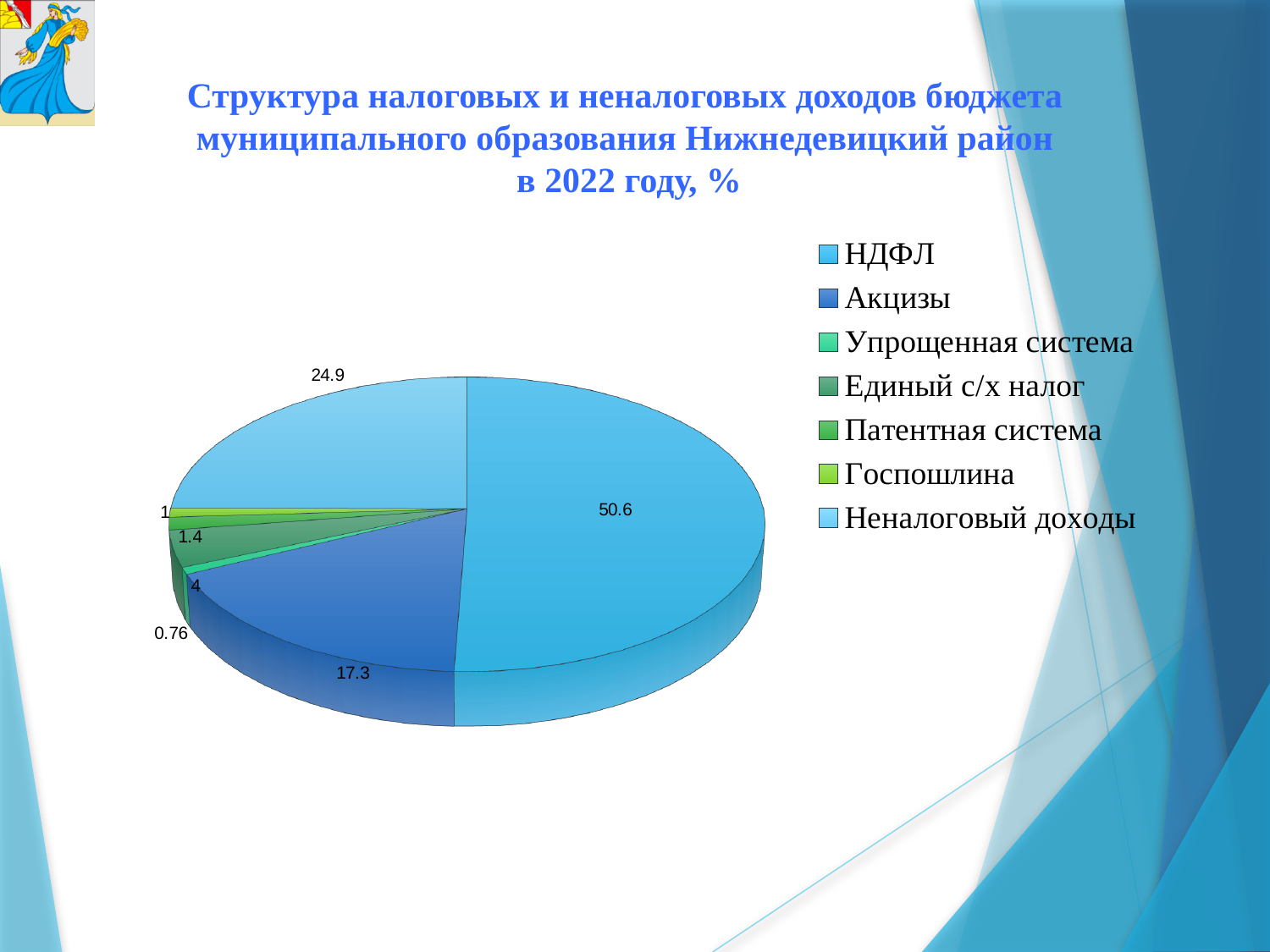
Which is larger, the value for Акцизы or the value for Неналоговый доходы? Неналоговый доходы Which category has the largest share of the pie? НДФЛ Which year does the chart title refer to? 2022 What is the difference between the values for НДФЛ and Неналоговый доходы? 25.7 What is the value for Акцизы? 17.3 What is the value for Неналоговый доходы? 24.9 How many entries does the legend list? 7 What is the value for НДФЛ? 50.6 What is the difference between the values for Неналоговый доходы and Акцизы? 7.6 What kind of chart is shown on the slide? pie chart How many slices does the pie chart have? 7 What is the value for Единый с/х налог? 4